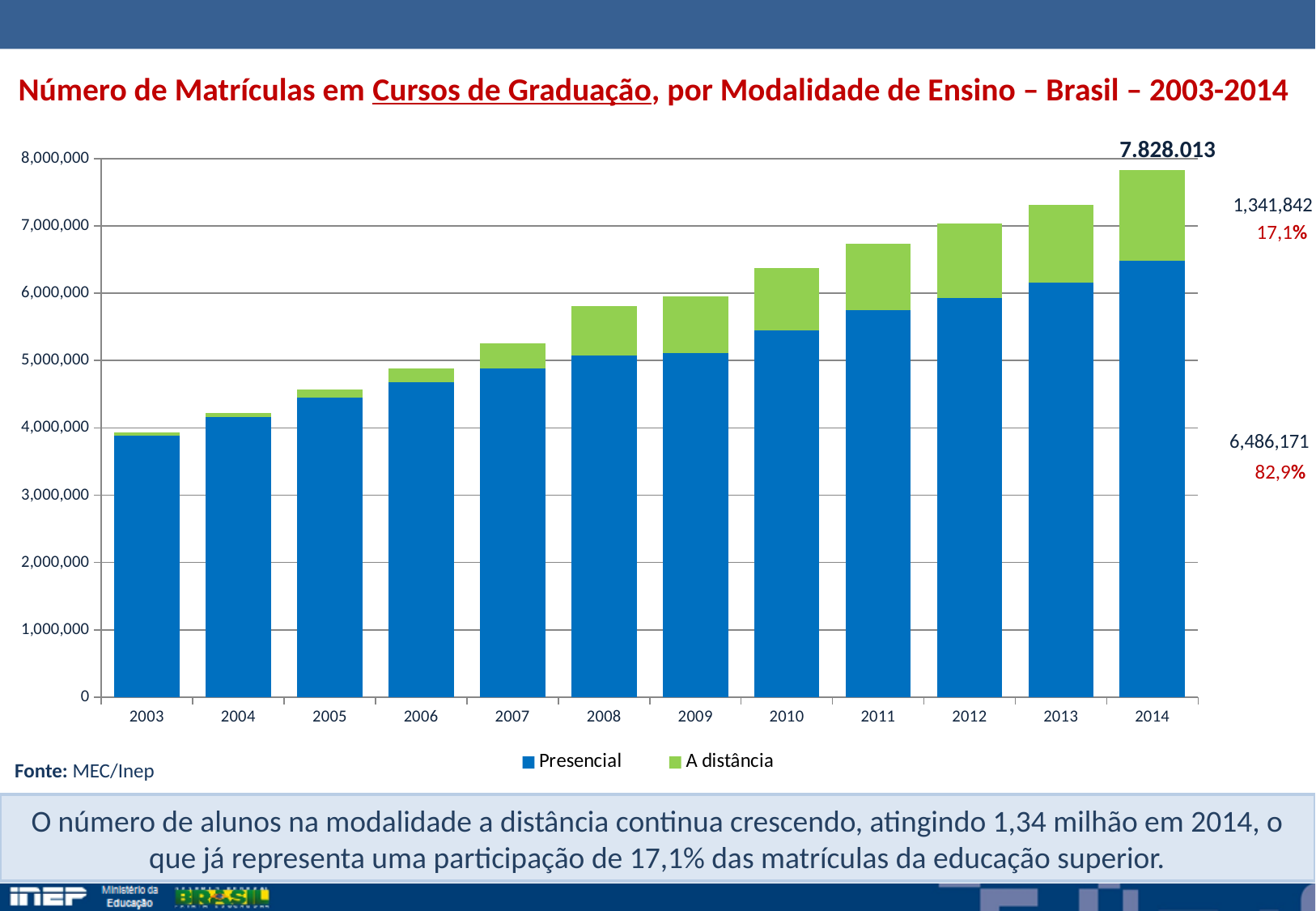
What is the value for Presencial in 2014? 6,486,171 What is the value for A distância in 2014? 1,341,842 Which year has the lowest total enrolment? 2003 Is the total value for 2010 greater or less than 6,000,000? greater How many years are shown on the x axis? 12 What is the difference between Presencial and A distância enrolments in 2014? 5,144,329 Which year has the highest total enrolment? 2014 Do total enrolments rise or fall from 2003 to 2014? Rise What kind of chart is shown on the slide? Stacked bar chart What percentage share of 2014 enrolments does A distância represent, as printed on the slide? 17,1% How many series does the legend list? 2 What is the total number of enrolments shown for 2014? 7.828.013